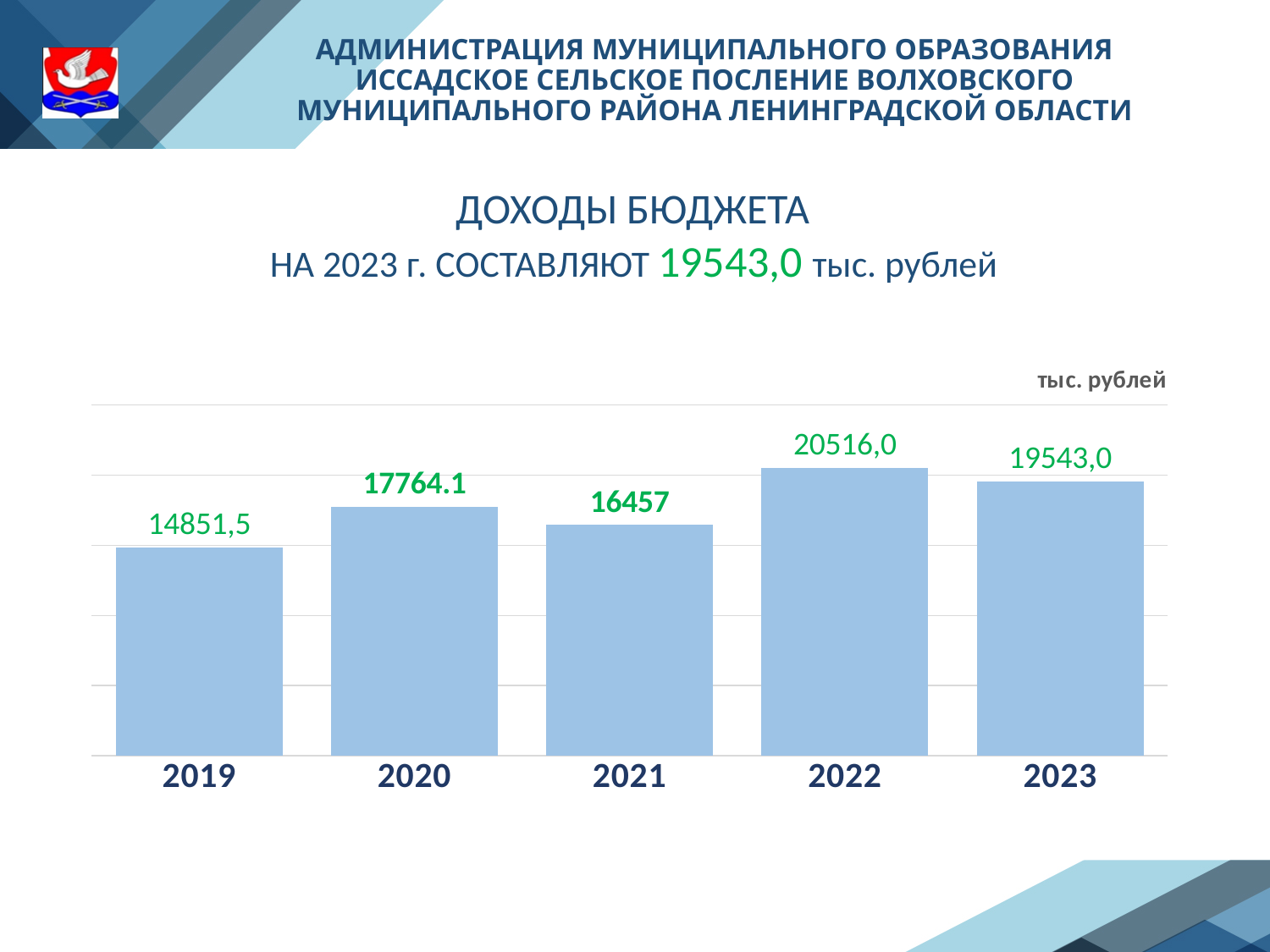
What type of chart is shown on the slide? Bar chart Which year has the lowest budget revenue in the chart? 2019 Which year has the highest budget revenue in the chart? 2022 What is the budget revenue value shown for 2022? 20516,0 What is the budget revenue value shown for 2020? 17764.1 How many years are shown on the x axis of the chart? 5 What is the budget revenue value shown for 2019? 14851,5 By how much does the 2022 value exceed the 2023 value? 973,0 What is the budget revenue value shown for 2021? 16457 What is the budget revenue value shown for 2023? 19543,0 Which is larger, the value for 2020 or the value for 2021? 2020 What is the difference between the 2021 value and the 2019 value? 1605,5